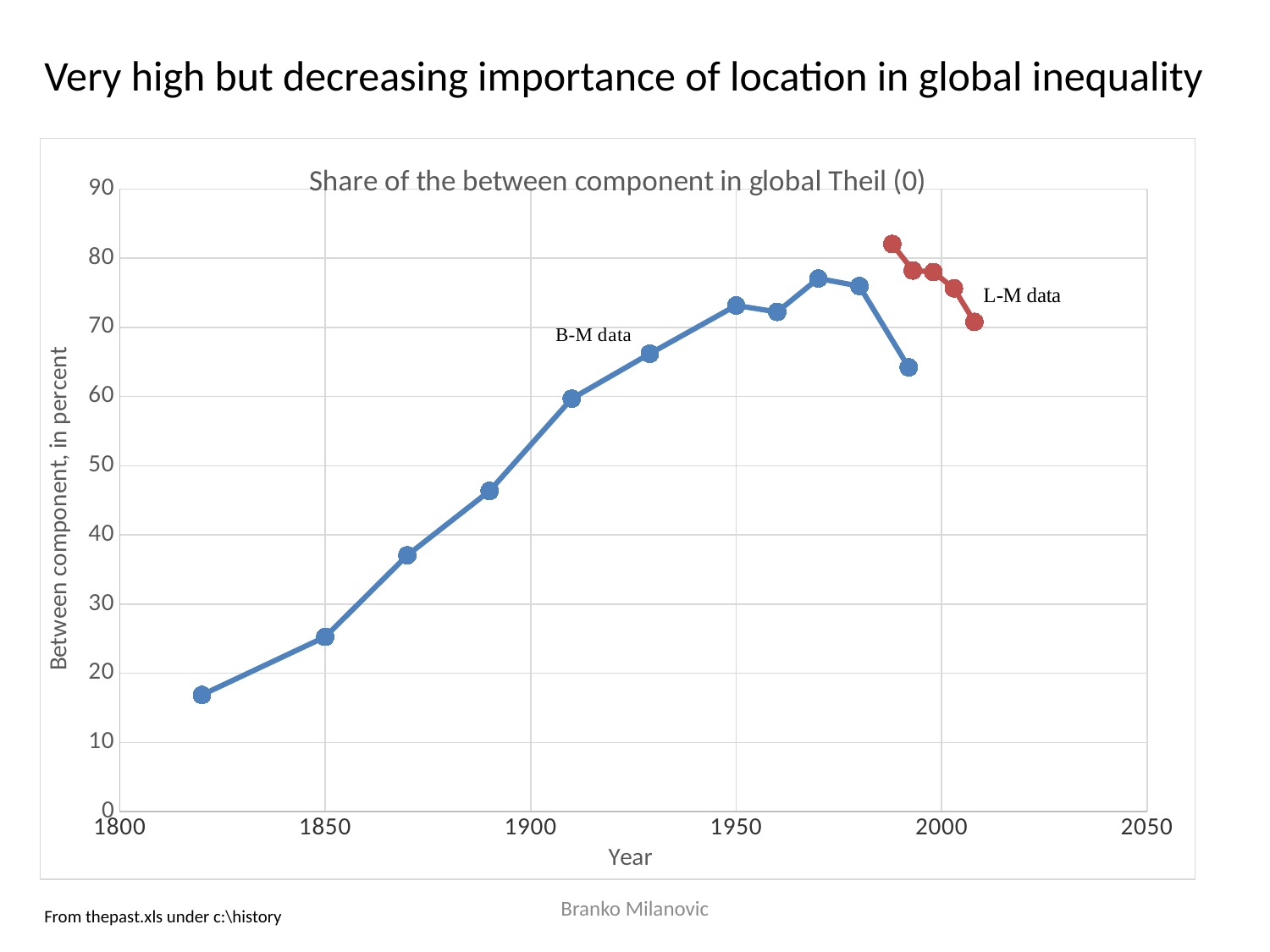
Which series reaches the higher value: B-M data or L-M data? L-M data What is the title of the chart? Share of the between component in global Theil (0) What kind of chart is shown on the slide? line chart How many data points does the L-M data series have? 5 Is the value of the B-M data series at 1820 greater or less than 20? less How many data points does the B-M data series have? 11 Is the first value of the L-M data series (around 1988) greater or less than 80? greater Do the values of the L-M data series rise or fall over time? fall What is the label of the vertical axis? Between component, in percent Do the values of the B-M data series rise or fall between 1820 and 1970? rise Is the value of the B-M data series at 1910 greater or less than 50? greater